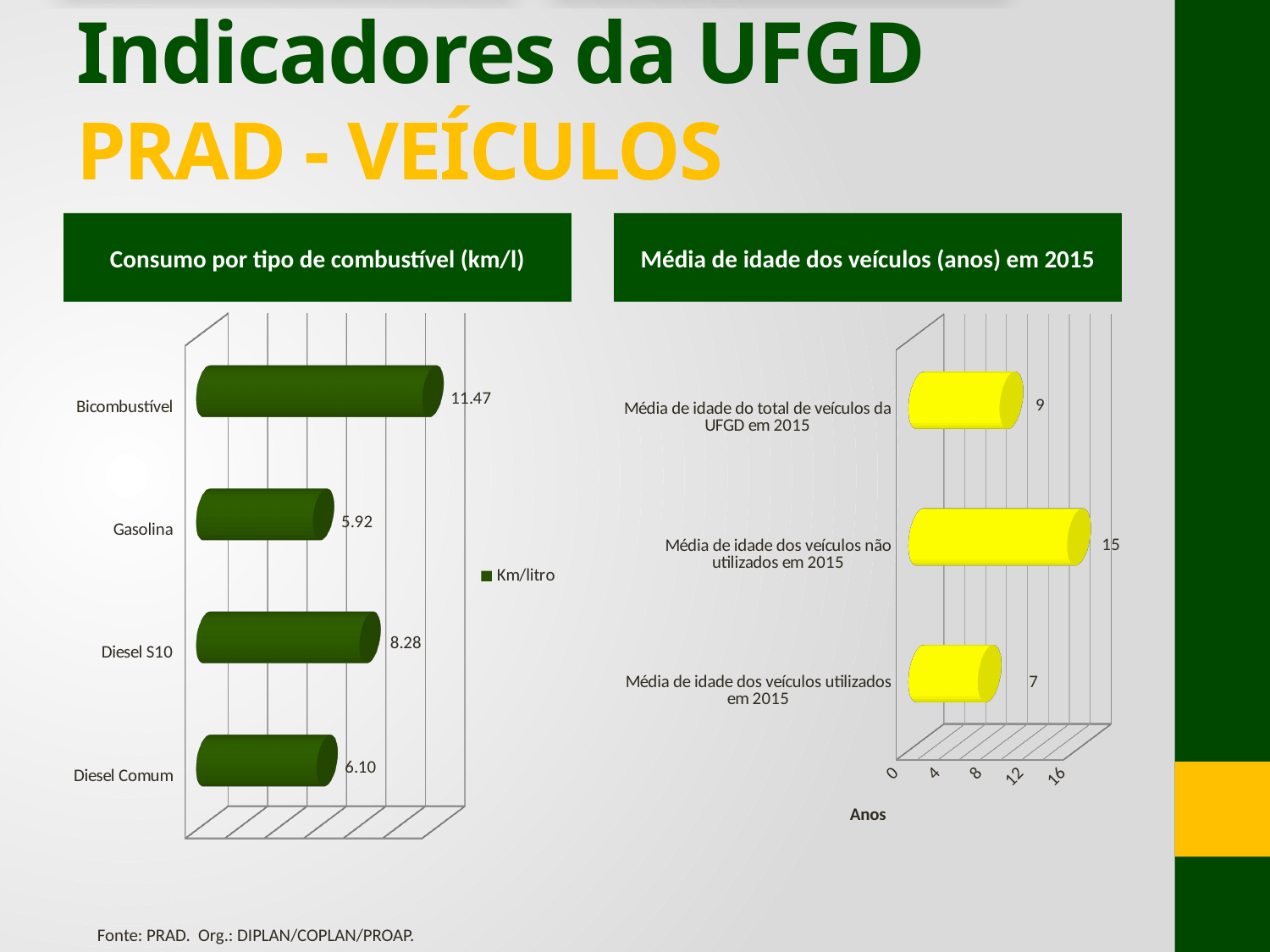
In the 'Consumo por tipo de combustível (km/l)' chart, which fuel type has the highest value? Bicombustível In the 'Média de idade dos veículos (anos) em 2015' chart, what is the value for 'Média de idade dos veículos utilizados em 2015'? 7 In the 'Média de idade dos veículos (anos) em 2015' chart, what is the difference between the non-utilized vehicles and the utilized vehicles? 8 In the 'Consumo por tipo de combustível (km/l)' chart, how many fuel types are shown? 4 In the 'Consumo por tipo de combustível (km/l)' chart, what is the difference between Bicombustível and Diesel Comum? 5.37 In the 'Consumo por tipo de combustível (km/l)' chart, which fuel type has the lowest value? Gasolina In the 'Média de idade dos veículos (anos) em 2015' chart, what is the value for 'Média de idade dos veículos não utilizados em 2015'? 15 In the 'Média de idade dos veículos (anos) em 2015' chart, which category has the highest value? Média de idade dos veículos não utilizados em 2015 In the 'Consumo por tipo de combustível (km/l)' chart, what series name does the legend show? Km/litro In the 'Consumo por tipo de combustível (km/l)' chart, what is the value for Bicombustível? 11.47 What kind of chart is the 'Média de idade dos veículos (anos) em 2015' chart? Bar chart In the 'Consumo por tipo de combustível (km/l)' chart, what is the value for Diesel S10? 8.28